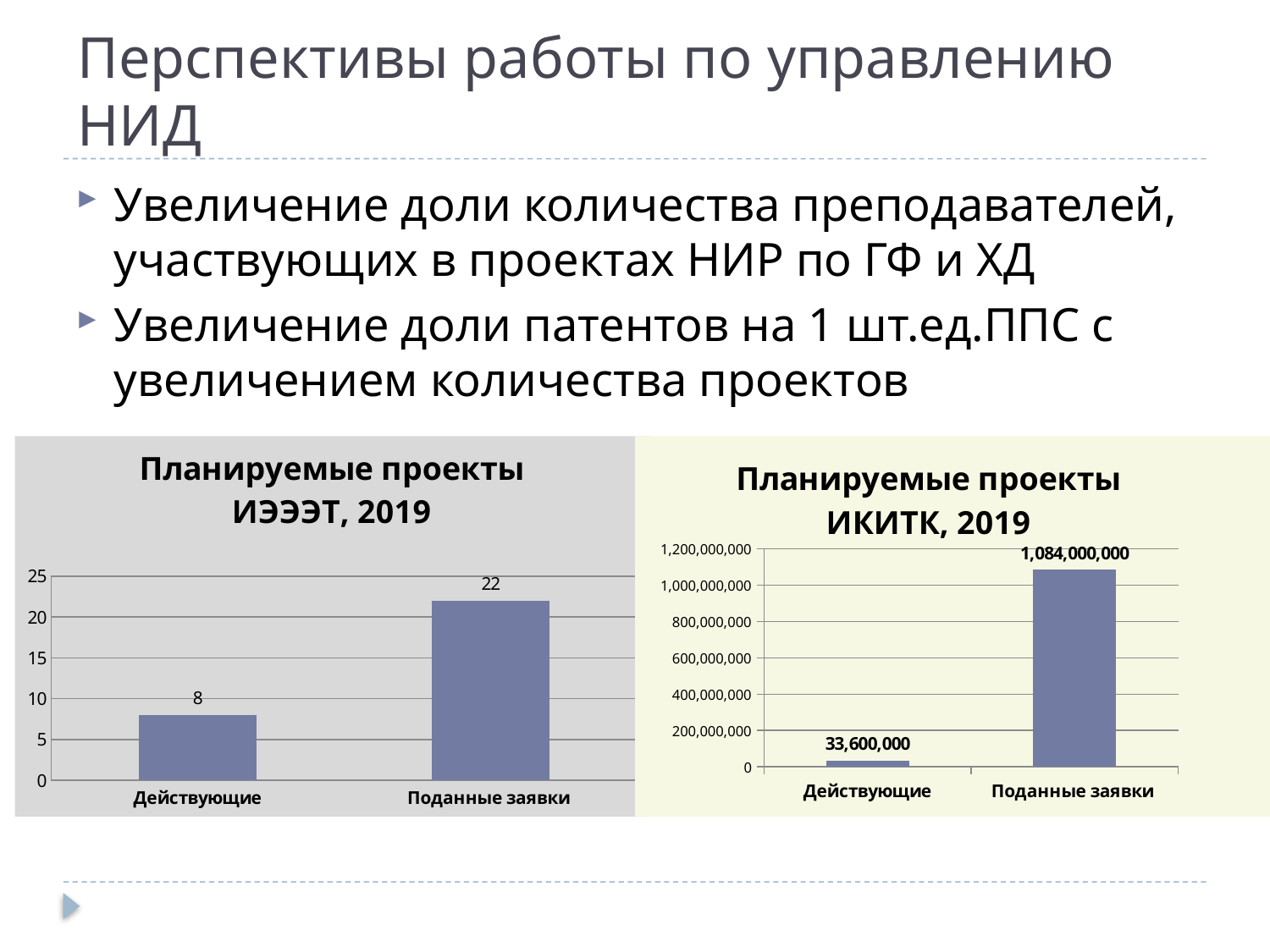
In the chart titled 'Планируемые проекты ИКИТК, 2019', which category has the lowest value? Действующие In the chart titled 'Планируемые проекты ИЭЭЭТ, 2019', what is the value for 'Поданные заявки'? 22 What is the title of the chart on the left side of the slide? Планируемые проекты ИЭЭЭТ, 2019 What kind of chart is the chart titled 'Планируемые проекты ИКИТК, 2019'? Bar chart In the chart titled 'Планируемые проекты ИКИТК, 2019', what is the value for 'Поданные заявки'? 1,084,000,000 In the chart titled 'Планируемые проекты ИКИТК, 2019', is the value for 'Поданные заявки' greater or less than 1,000,000,000? greater In the chart titled 'Планируемые проекты ИКИТК, 2019', what is the value for 'Действующие'? 33,600,000 In the chart titled 'Планируемые проекты ИЭЭЭТ, 2019', what is the difference between 'Поданные заявки' and 'Действующие'? 14 How many categories are shown in the chart titled 'Планируемые проекты ИЭЭЭТ, 2019'? 2 In the chart titled 'Планируемые проекты ИКИТК, 2019', what is the difference between 'Поданные заявки' and 'Действующие'? 1,050,400,000 In the chart titled 'Планируемые проекты ИЭЭЭТ, 2019', which category has the highest value? Поданные заявки In the chart titled 'Планируемые проекты ИЭЭЭТ, 2019', what is the value for 'Действующие'? 8